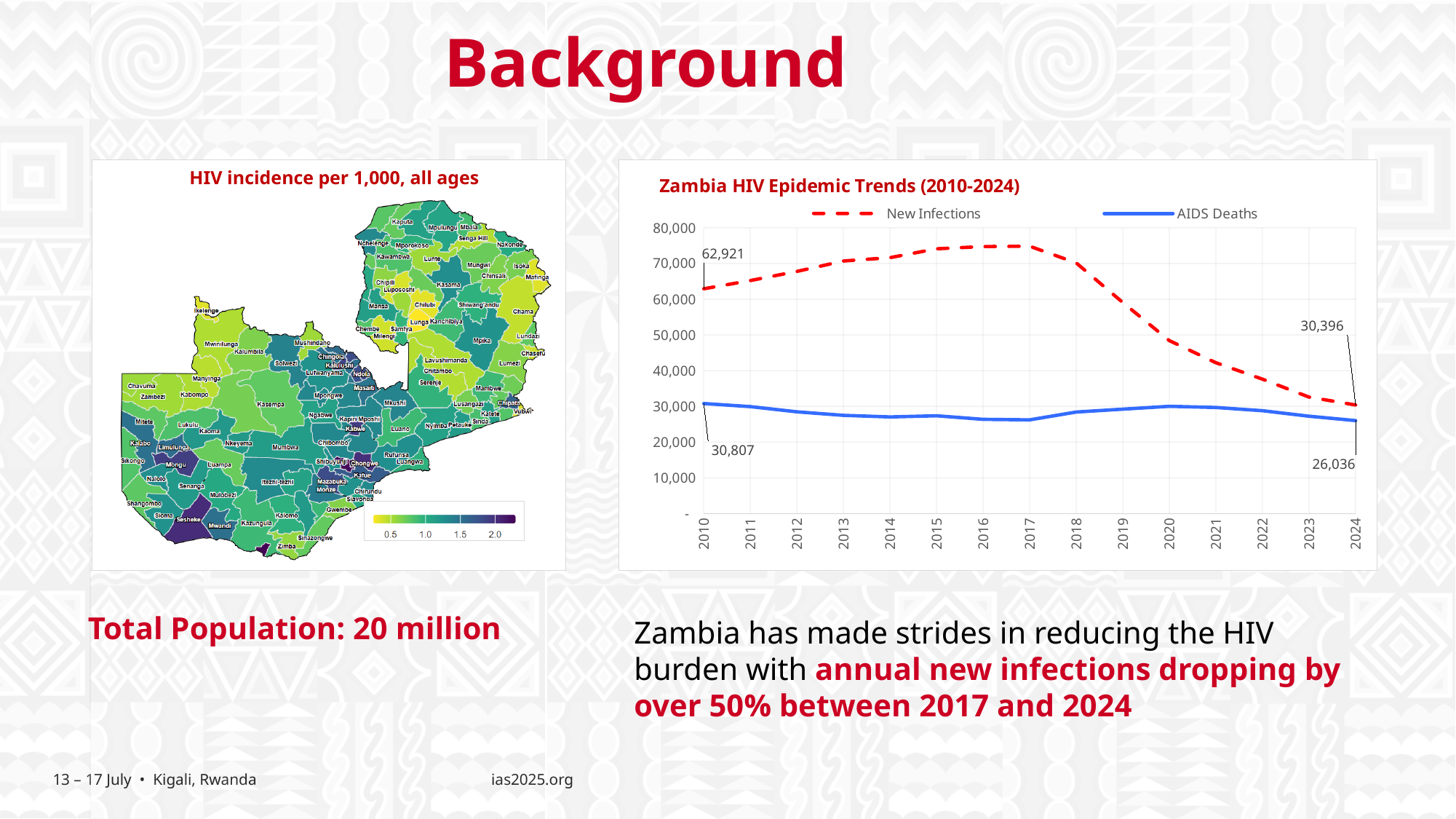
What kind of chart is the Zambia HIV Epidemic Trends chart? line chart In the Zambia HIV Epidemic Trends chart, what is the value of New Infections in 2010? 62,921 In the Zambia HIV Epidemic Trends chart, what is the value of New Infections in 2024? 30,396 In the Zambia HIV Epidemic Trends chart, what is the difference between AIDS Deaths in 2010 and in 2024? 4,771 How many series does the legend of the Zambia HIV Epidemic Trends chart list? 2 In the Zambia HIV Epidemic Trends chart, what is the value of AIDS Deaths in 2010? 30,807 In the Zambia HIV Epidemic Trends chart, is the value for New Infections in 2020 greater or less than 50,000? less In the Zambia HIV Epidemic Trends chart, what is the value of AIDS Deaths in 2024? 26,036 In the Zambia HIV Epidemic Trends chart, do New Infections rise or fall from 2017 to 2024? fall In the Zambia HIV Epidemic Trends chart, is the value for New Infections in 2016 greater or less than 70,000? greater In the Zambia HIV Epidemic Trends chart, by how much did New Infections fall between 2010 and 2024? 32,525 In the Zambia HIV Epidemic Trends chart, which series has the larger value in 2010, New Infections or AIDS Deaths? New Infections